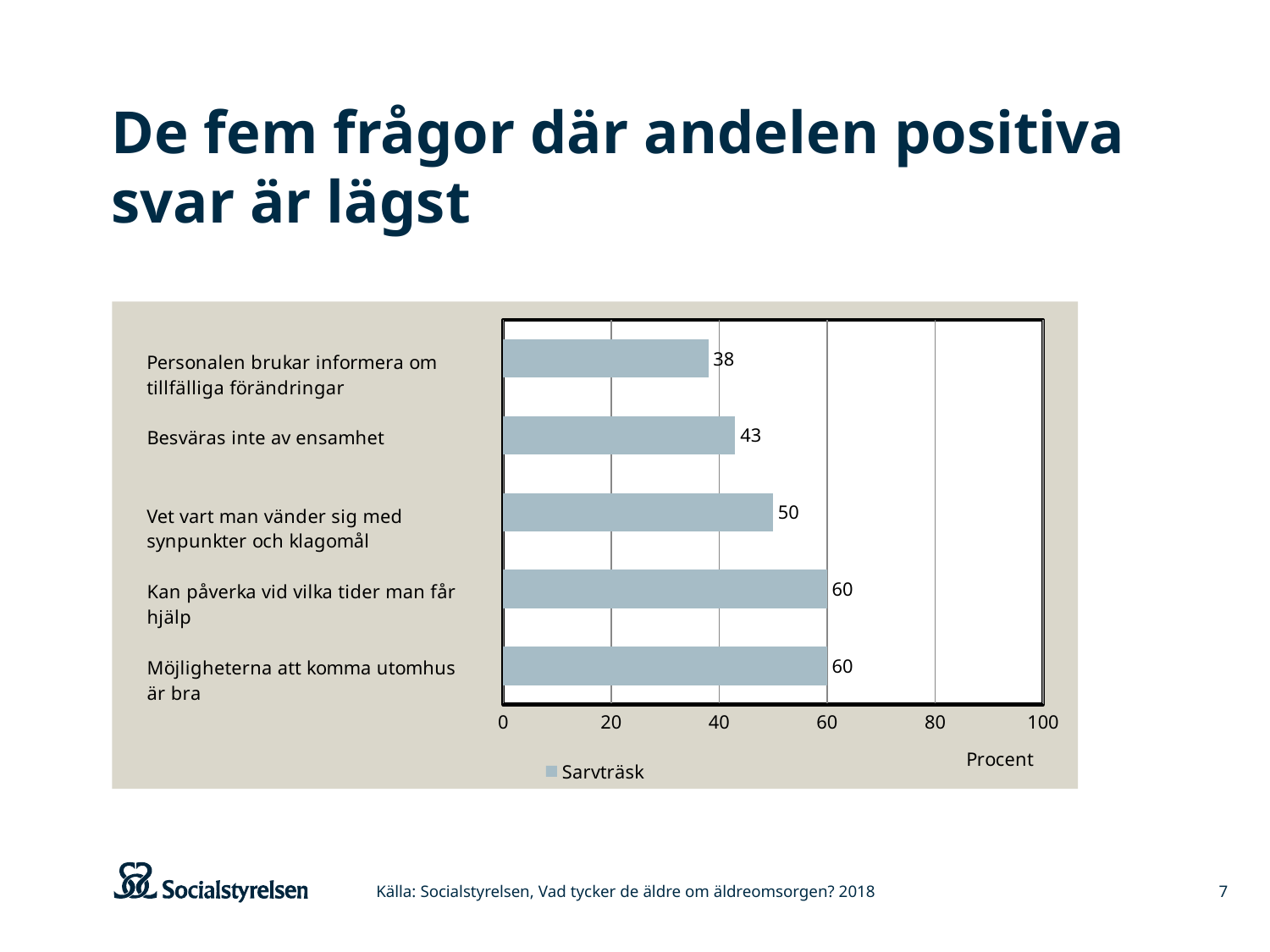
How many categories are shown in the chart? 5 How many series does the legend list? 1 What is the difference between the values for "Kan påverka vid vilka tider man får hjälp" and "Besväras inte av ensamhet"? 17 What is the difference between the values for "Vet vart man vänder sig med synpunkter och klagomål" and "Personalen brukar informera om tillfälliga förändringar"? 12 What is the value for "Besväras inte av ensamhet"? 43 What is the name of the series shown in the legend? Sarvträsk Is the value for "Personalen brukar informera om tillfälliga förändringar" greater or less than 40? less What is the value for "Vet vart man vänder sig med synpunkter och klagomål"? 50 What is the value for "Personalen brukar informera om tillfälliga förändringar"? 38 Which category has the lowest value? Personalen brukar informera om tillfälliga förändringar What kind of chart is shown on the slide? bar chart Which is larger, the value for "Besväras inte av ensamhet" or the value for "Vet vart man vänder sig med synpunkter och klagomål"? Vet vart man vänder sig med synpunkter och klagomål